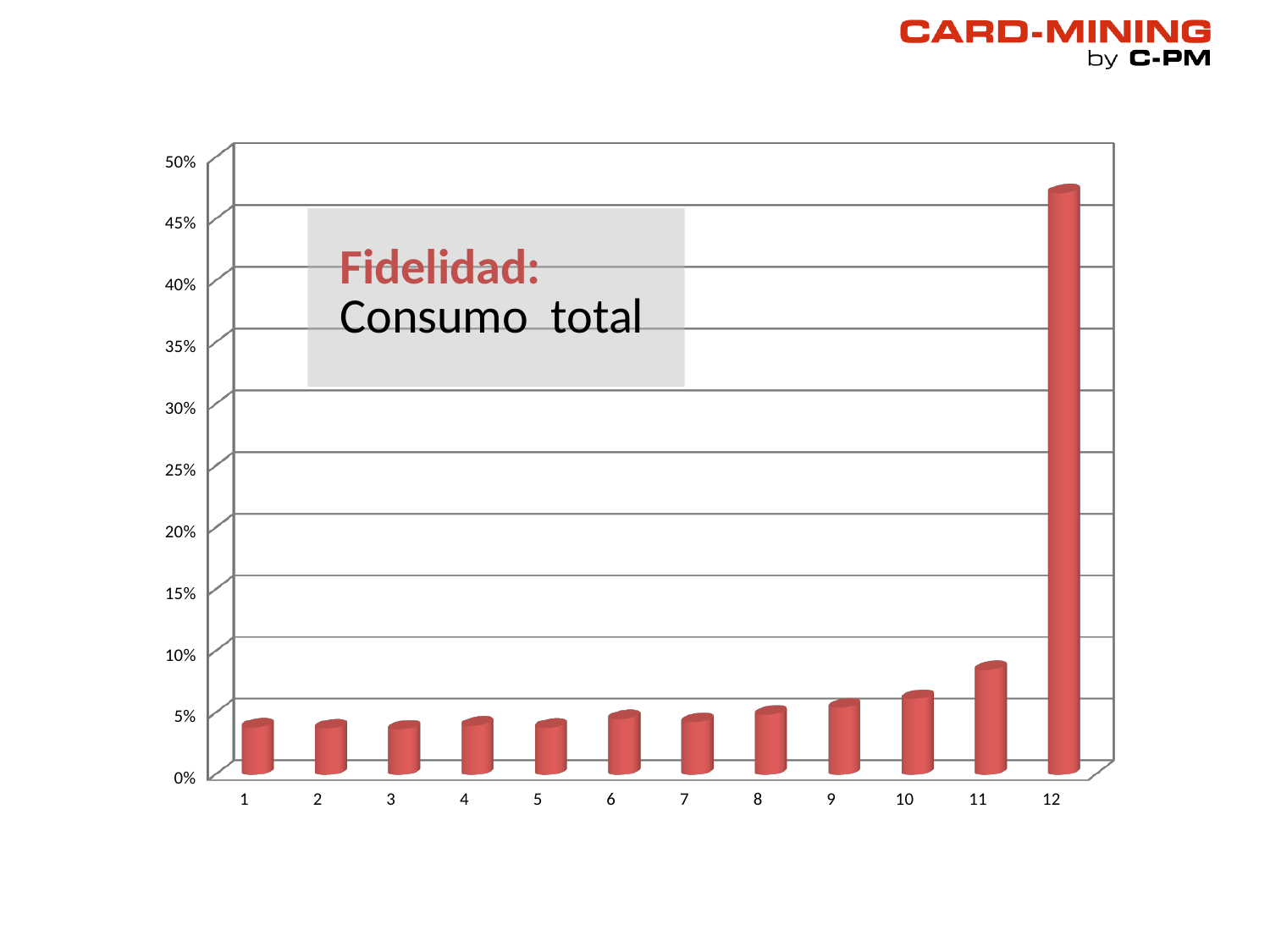
Which is larger, the value for category 12 or the value for category 11? 12 Is the value for category 11 greater or less than 10%? less Which is larger, the value for category 11 or the value for category 1? 11 Is the value for category 12 greater or less than 45%? greater How many categories are plotted along the x axis? 12 Is the value for category 10 greater or less than 10%? less Do the values generally rise or fall from category 1 to category 12? rise What is the title shown on the chart? Fidelidad: Consumo total Which category has the highest value? 12 What kind of chart is shown on the slide? bar chart